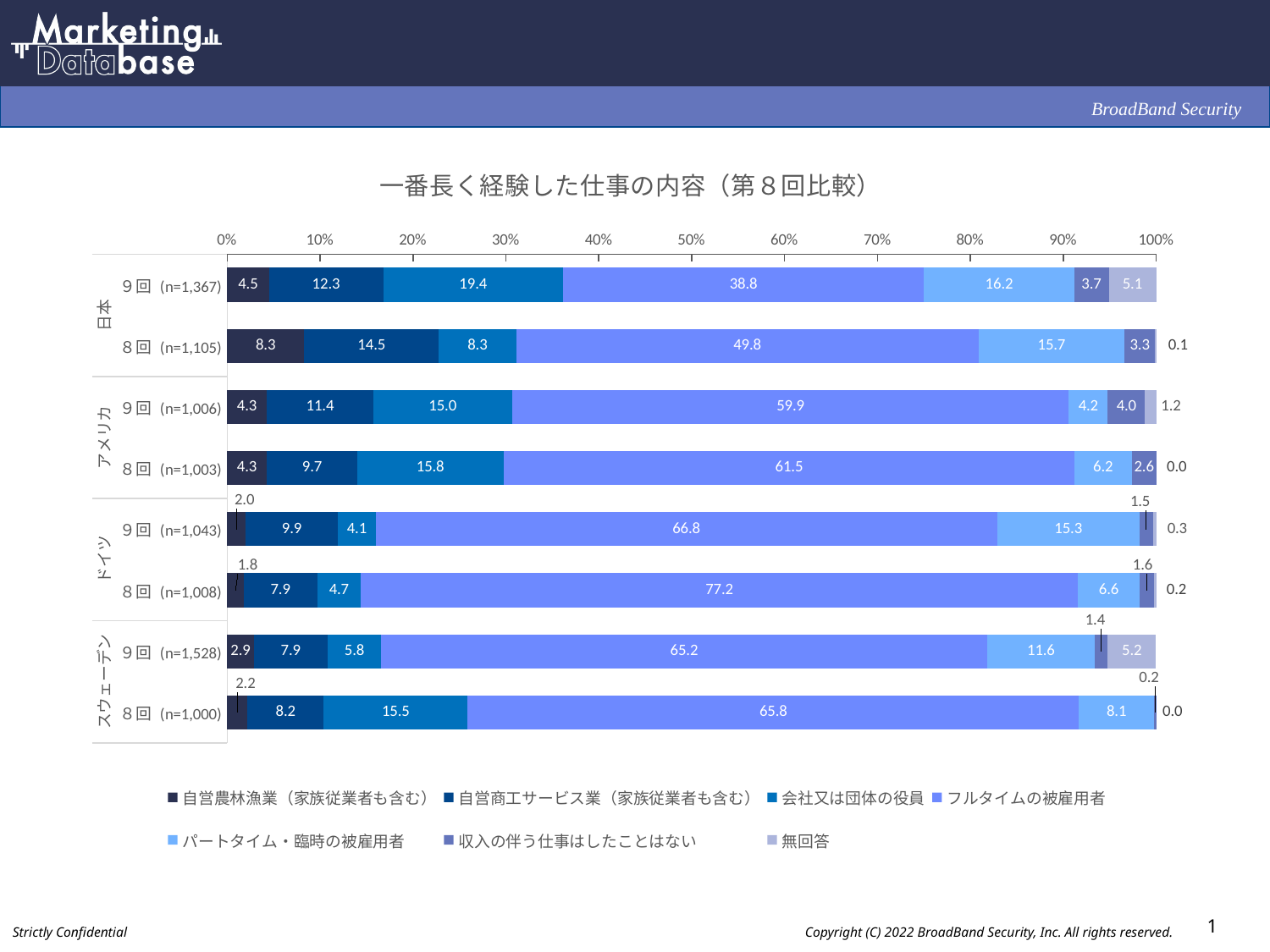
What is the value of フルタイムの被雇用者 for 日本 9回 (n=1,367)? 38.8 How many bars (survey rows) are plotted in the chart? 8 What is the difference in フルタイムの被雇用者 between 日本 8回 (n=1,105) and 日本 9回 (n=1,367)? 11.0 What is the value of 無回答 for スウェーデン 9回 (n=1,528)? 5.2 What is the title of the chart? 一番長く経験した仕事の内容（第８回比較） What is the value of パートタイム・臨時の被雇用者 for ドイツ 9回 (n=1,043)? 15.3 What type of chart is shown on the slide? Stacked bar chart Which row has the lowest value for フルタイムの被雇用者? 日本 9回 (n=1,367) What is the value of 会社又は団体の役員 for スウェーデン 8回 (n=1,000)? 15.5 How many series does the legend list? 7 Which is larger: 自営商工サービス業（家族従業者も含む） for アメリカ 9回 (n=1,006) or for アメリカ 8回 (n=1,003)? アメリカ 9回 (n=1,006) Which row has the highest value for フルタイムの被雇用者? ドイツ 8回 (n=1,008)